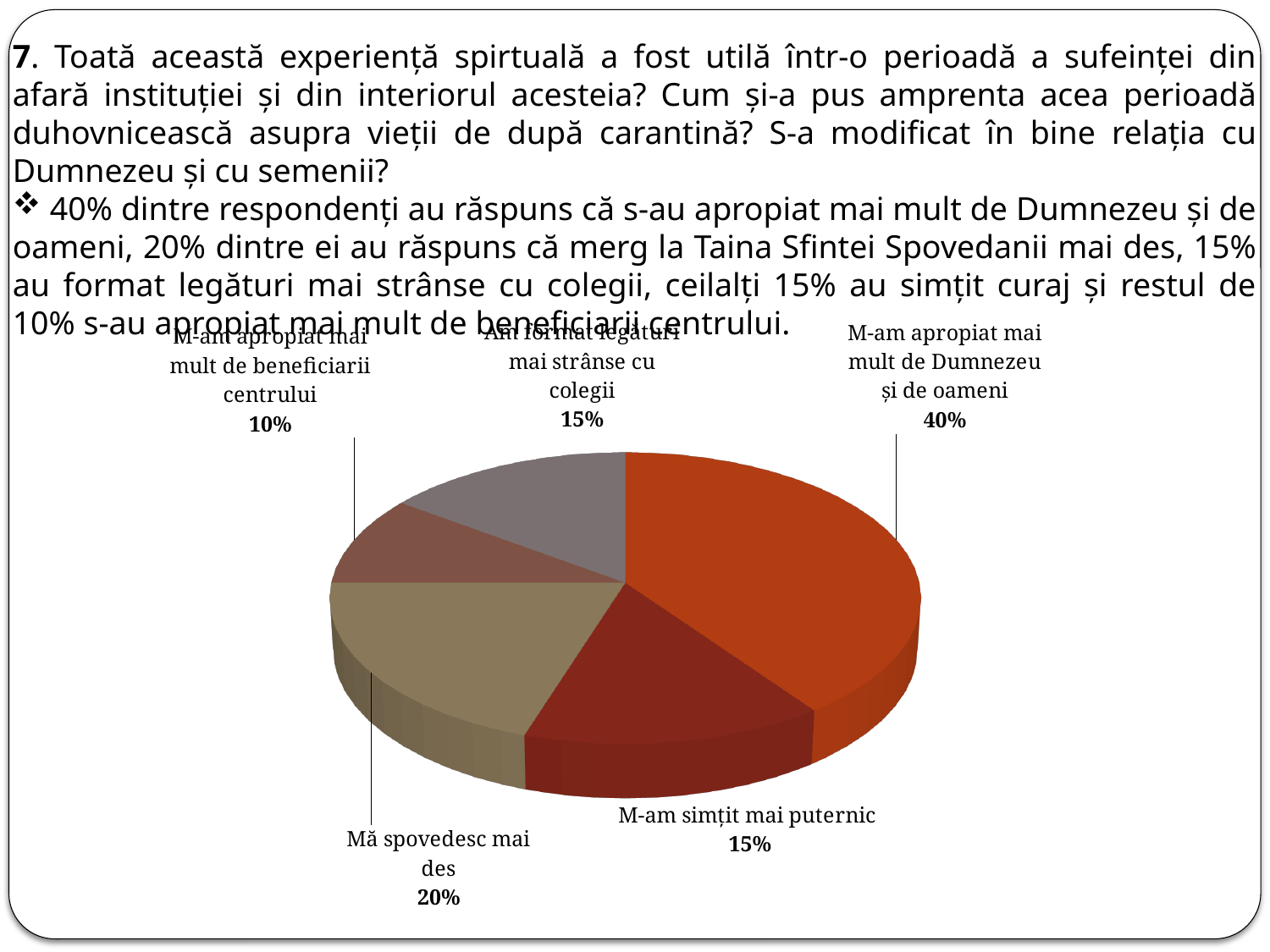
What share of respondents answered "M-am apropiat mai mult de Dumnezeu și de oameni"? 40% What is the difference in percentage points between "M-am apropiat mai mult de Dumnezeu și de oameni" and "Mă spovedesc mai des"? 20 Which is larger: the share for "Mă spovedesc mai des" or the share for "M-am simțit mai puternic"? Mă spovedesc mai des What percentage is shown for "Mă spovedesc mai des"? 20% Which slice of the pie chart is the smallest? M-am apropiat mai mult de beneficiarii centrului Which two categories in the pie chart have the same share of 15%? Am format legături mai strânse cu colegii; M-am simțit mai puternic How many slices does the pie chart have? 5 What percentage is shown for "M-am apropiat mai mult de beneficiarii centrului"? 10% What colour is the largest slice of the pie chart? orange-red What kind of chart is shown on the slide? pie chart Which slice of the pie chart is the largest? M-am apropiat mai mult de Dumnezeu și de oameni What percentage is shown for "M-am simțit mai puternic"? 15%